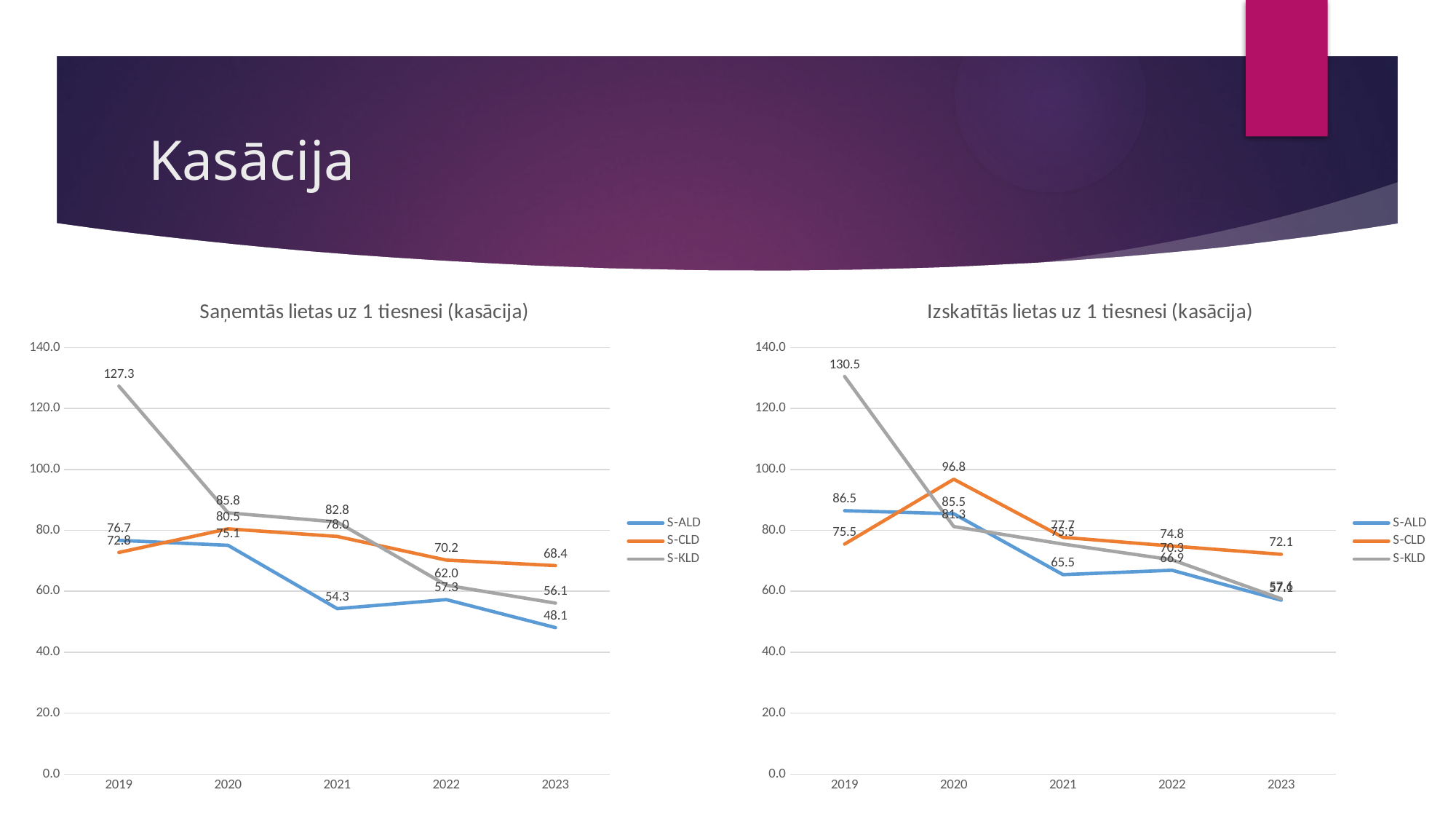
In the chart titled "Saņemtās lietas uz 1 tiesnesi (kasācija)", what is the value for S-KLD in 2019? 127.3 In the chart titled "Saņemtās lietas uz 1 tiesnesi (kasācija)", does the S-ALD line generally rise or fall from 2019 to 2023? fall In the chart titled "Izskatītās lietas uz 1 tiesnesi (kasācija)", what is the value for S-ALD in 2019? 86.5 In the chart titled "Saņemtās lietas uz 1 tiesnesi (kasācija)", what is the difference between the S-KLD values in 2019 and 2020? 41.5 What kind of chart is the chart titled "Saņemtās lietas uz 1 tiesnesi (kasācija)"? line chart In the chart titled "Saņemtās lietas uz 1 tiesnesi (kasācija)", which year has the highest value for S-CLD? 2020 In the chart titled "Izskatītās lietas uz 1 tiesnesi (kasācija)", which series has the highest value in 2019? S-KLD In the chart titled "Izskatītās lietas uz 1 tiesnesi (kasācija)", which is larger in 2021: S-CLD or S-ALD? S-CLD How many series does the legend of the chart titled "Izskatītās lietas uz 1 tiesnesi (kasācija)" list? 3 In the chart titled "Izskatītās lietas uz 1 tiesnesi (kasācija)", what is the value for S-CLD in 2020? 96.8 In the chart titled "Saņemtās lietas uz 1 tiesnesi (kasācija)", which series has the lowest value in 2021? S-ALD In the chart titled "Saņemtās lietas uz 1 tiesnesi (kasācija)", what is the value for S-ALD in 2023? 48.1